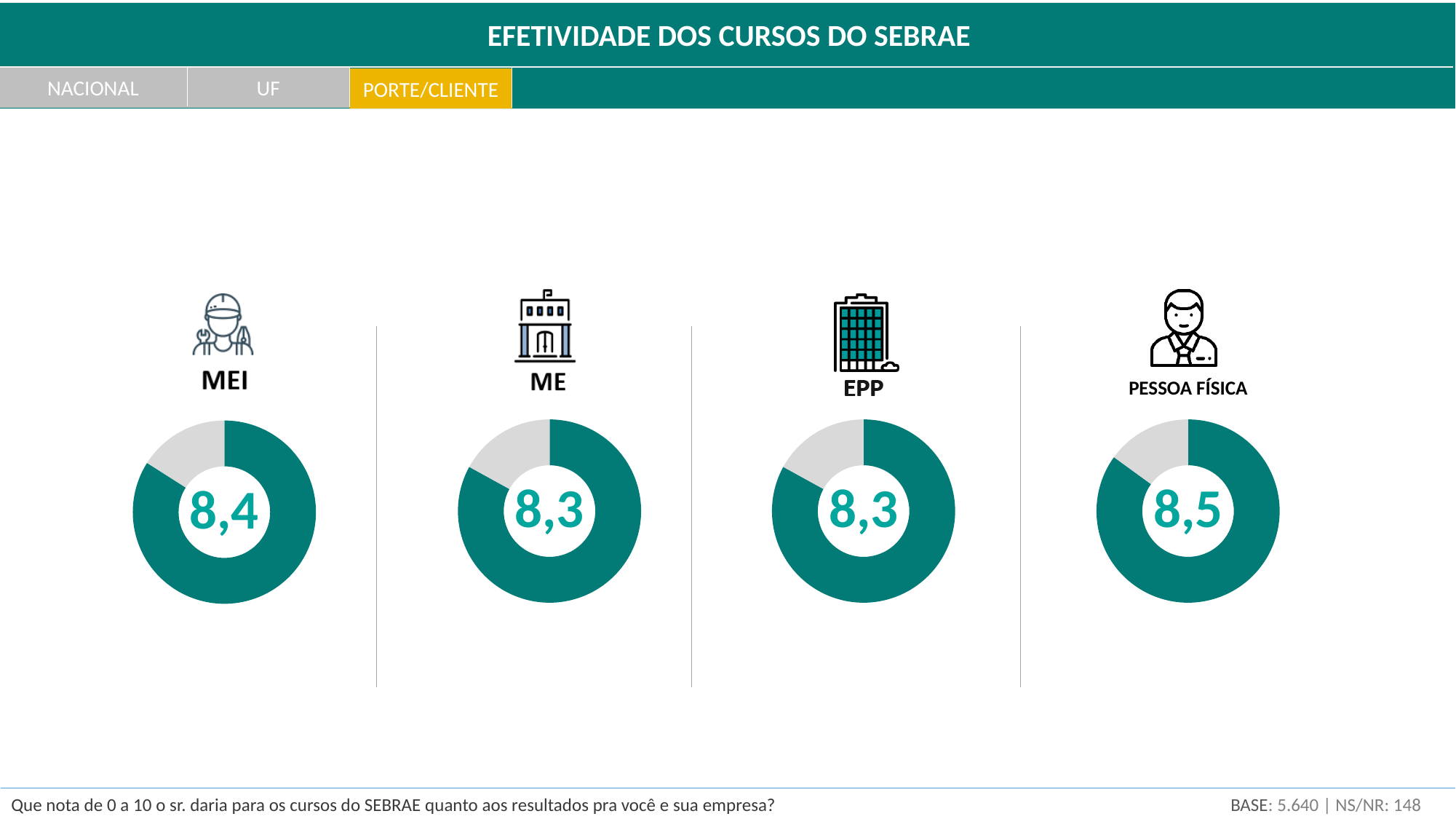
Which score is larger, MEI or PESSOA FÍSICA? PESSOA FÍSICA Which group has the highest score among the four donut charts? PESSOA FÍSICA What is the difference between the PESSOA FÍSICA score and the ME score? 0,2 What is the title of the slide containing the donut charts? EFETIVIDADE DOS CURSOS DO SEBRAE What score is shown in the PESSOA FÍSICA donut chart? 8,5 What is the difference between the MEI score and the EPP score? 0,1 What score is shown in the ME donut chart? 8,3 What score is shown in the MEI donut chart? 8,4 How many donut charts are shown on the slide? 4 Which two groups share the lowest score among the four donut charts? ME and EPP What kind of chart is used to display each group's score? Donut chart What score is shown in the EPP donut chart? 8,3